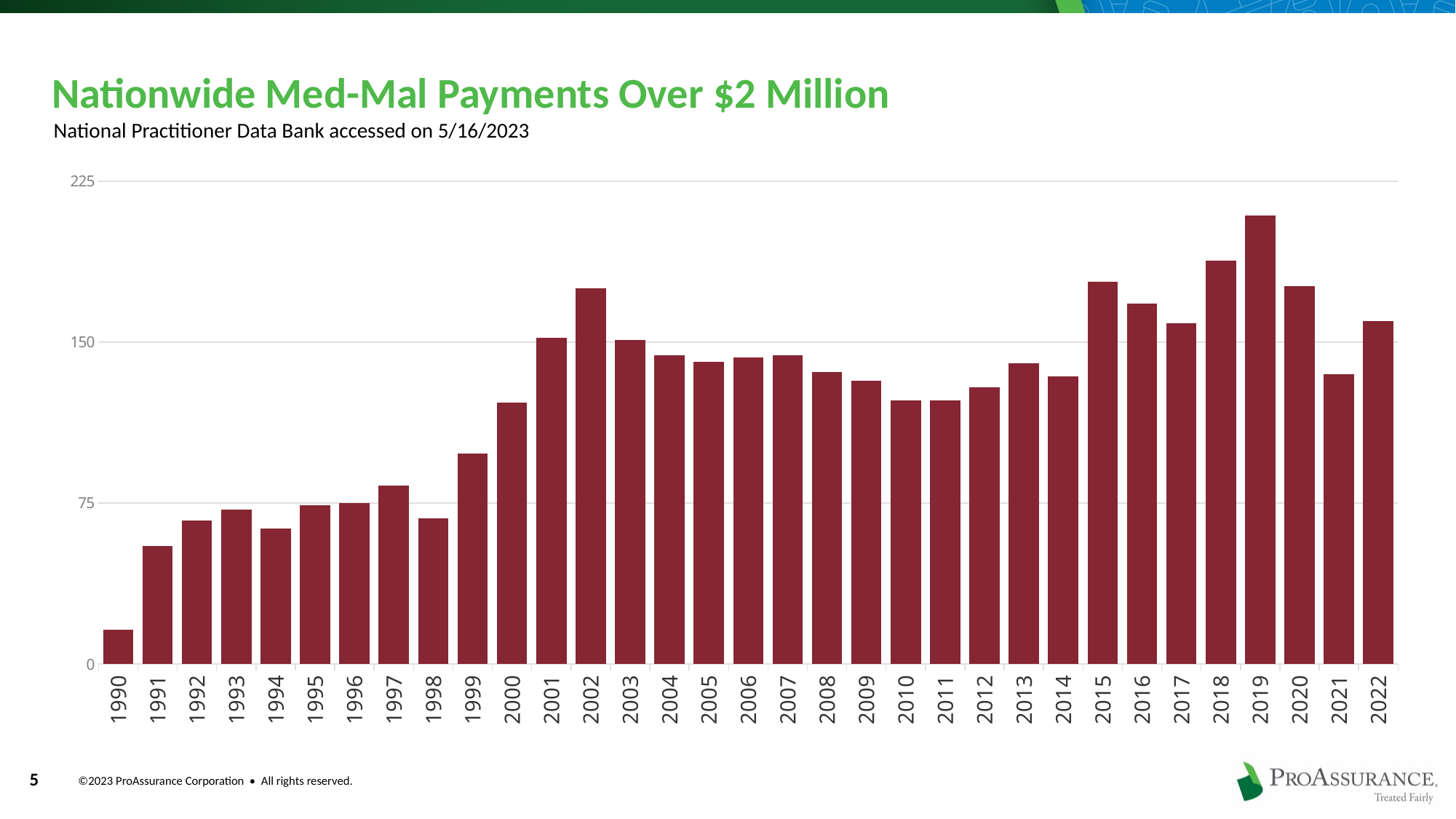
How many years are plotted on the chart? 33 Which year has the lowest number of med-mal payments over $2 million? 1990 Which year has the larger value, 2019 or 2002? 2019 Is the value for 1990 greater or less than 75? less Do the values generally rise or fall from 1990 to 2002? rise Is the value for 2021 greater or less than 150? less What is the title of the chart on the slide? Nationwide Med-Mal Payments Over $2 Million Which year has the highest number of med-mal payments over $2 million? 2019 Is the value for 1999 greater or less than 75? greater What kind of chart is shown on the slide? bar chart